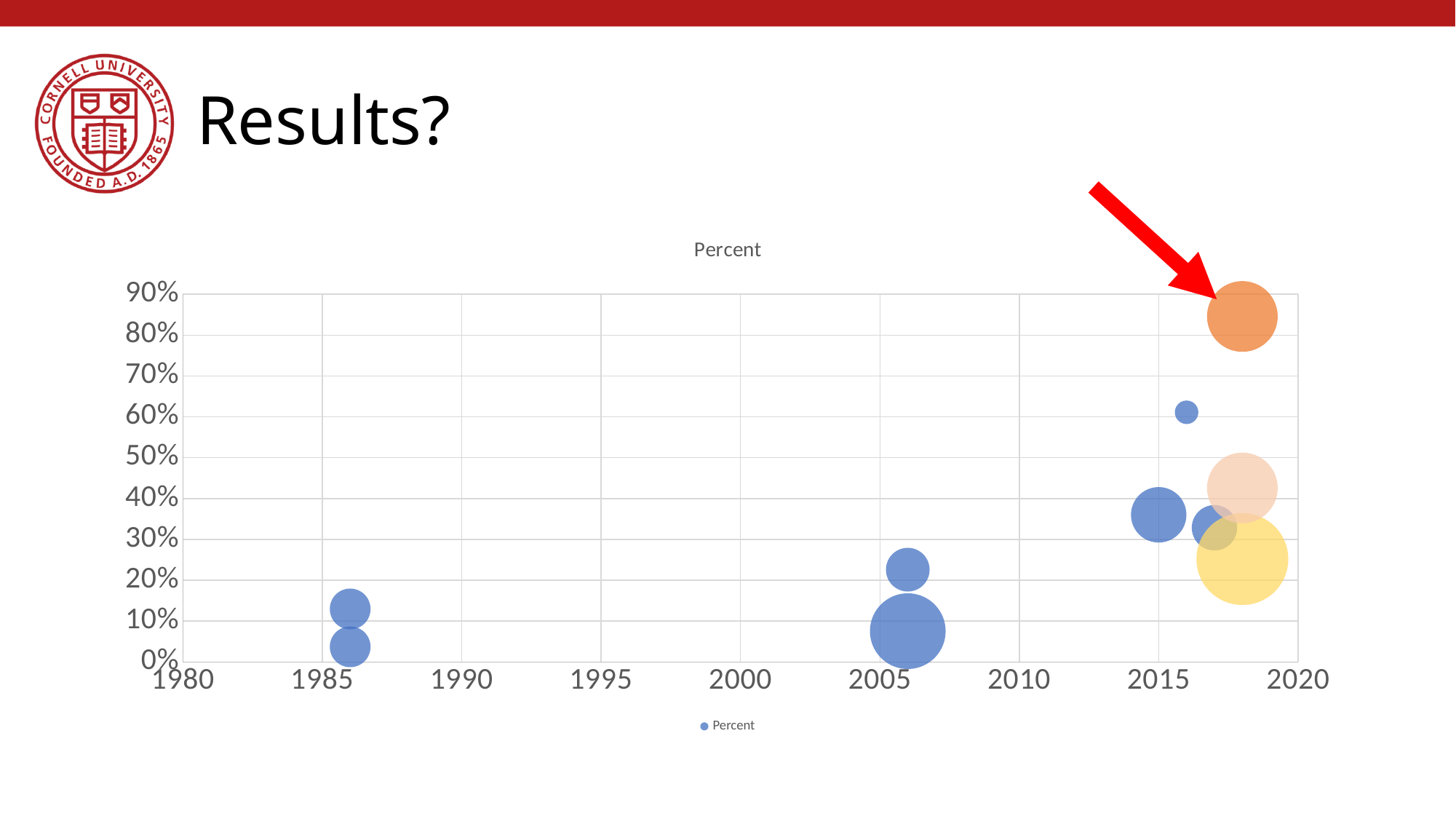
How many series does the chart legend list? 1 Which bubble has the highest value on the chart? The orange bubble near 2018 Do the bubble values generally rise or fall as the years increase along the x axis? Rise What is the range of years shown on the x axis? 1980 to 2020 Is the value of the blue bubble at 2015 greater or less than 50%? less What kind of chart is shown on the slide? Bubble chart Is the value of the highest bubble (the orange one near 2018) greater or less than 80%? greater Is the value of the largest blue bubble near 2006 greater or less than 20%? less What is the title of the chart? Percent Which is higher: the blue bubble at 2015 or the small blue bubble at 2016? The bubble at 2016